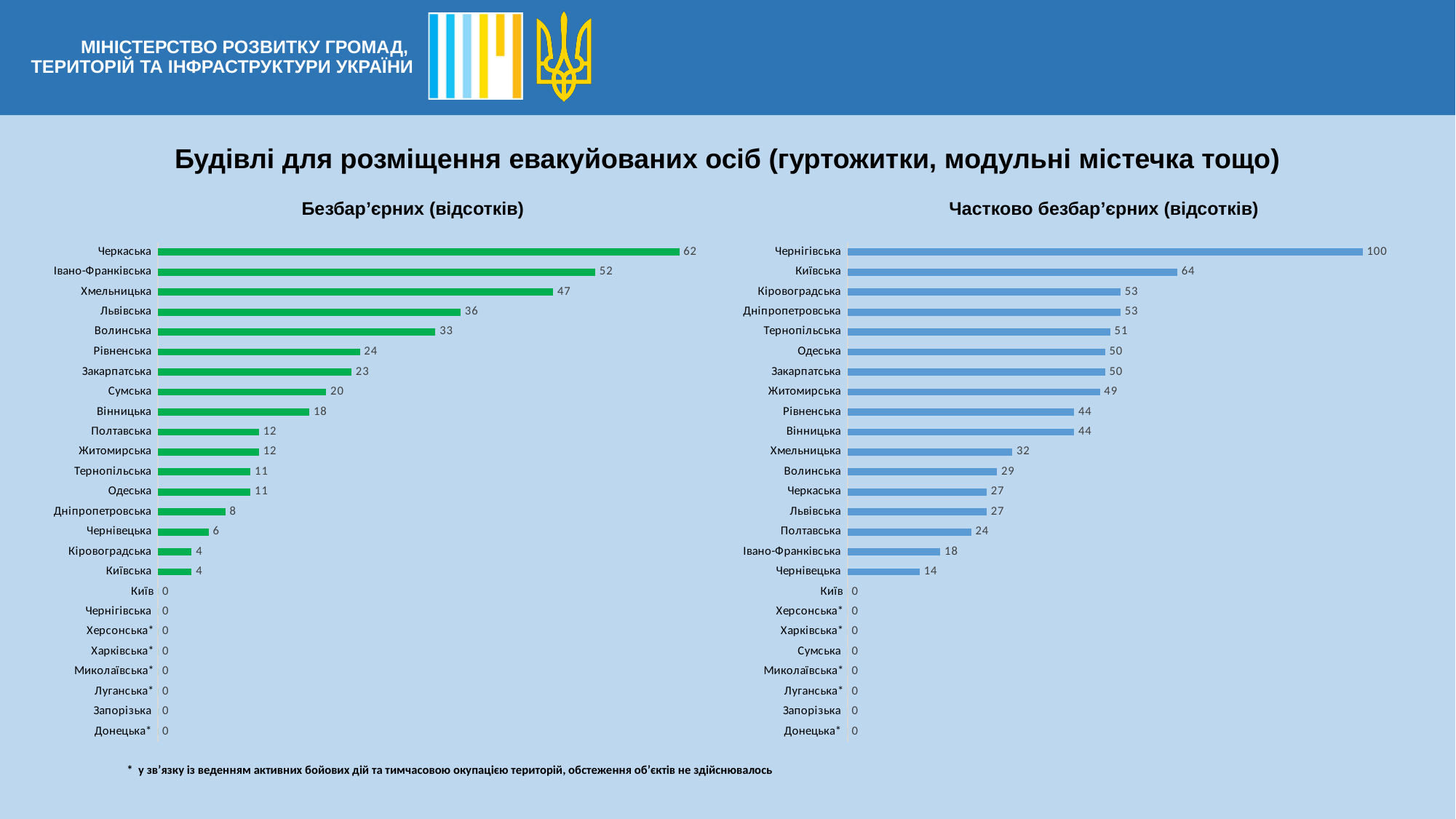
How many categories are shown in the chart titled "Безбар’єрних (відсотків)"? 25 In the chart titled "Безбар’єрних (відсотків)", what is the value for Дніпропетровська? 8 In the chart titled "Частково безбар’єрних (відсотків)", which category has the highest value? Чернігівська What kind of chart is the chart titled "Частково безбар’єрних (відсотків)"? bar chart What is the title of the chart on the left side of the slide? Безбар’єрних (відсотків) In the chart titled "Частково безбар’єрних (відсотків)", what is the difference between the values for Київська and Волинська? 35 In the chart titled "Безбар’єрних (відсотків)", what is the value for Хмельницька? 47 In the chart titled "Безбар’єрних (відсотків)", which is larger: the value for Волинська or the value for Рівненська? Волинська In the chart titled "Частково безбар’єрних (відсотків)", what is the value for Житомирська? 49 In the chart titled "Безбар’єрних (відсотків)", what is the difference between the values for Івано-Франківська and Львівська? 16 In the chart titled "Безбар’єрних (відсотків)", which category has the highest value? Черкаська In the chart titled "Частково безбар’єрних (відсотків)", which is larger: the value for Полтавська or the value for Чернівецька? Полтавська